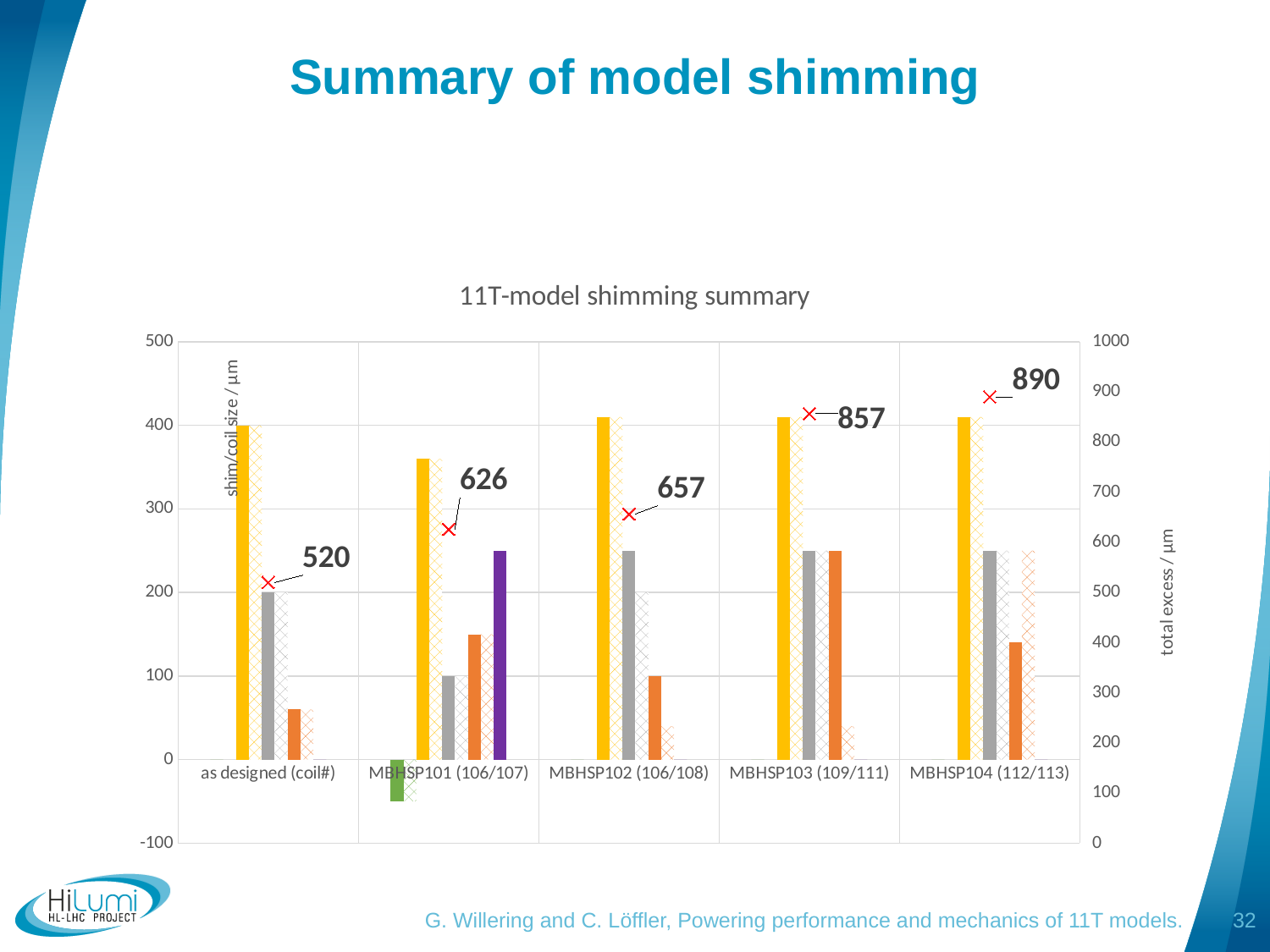
Which has a larger labelled total excess value, MBHSP102 (106/108) or MBHSP103 (109/111)? MBHSP103 (109/111) Which category has the highest labelled total excess value? MBHSP104 (112/113) Do the labelled total excess values rise or fall from left to right across the categories? rise How many categories are shown on the x axis? 5 What is the total excess value labelled for MBHSP102 (106/108)? 657 What is the difference between the labelled total excess values of MBHSP101 (106/107) and the 'as designed (coil#)' category? 106 What is the total excess value labelled for MBHSP104 (112/113)? 890 Is the value of the solid yellow bar for MBHSP101 (106/107) greater or less than 300 on the left axis? greater What is the title of the chart? 11T-model shimming summary Which category has the lowest labelled total excess value? as designed (coil#) What is the difference between the labelled total excess values of MBHSP104 (112/113) and MBHSP103 (109/111)? 33 What is the total excess value labelled for the 'as designed (coil#)' category? 520